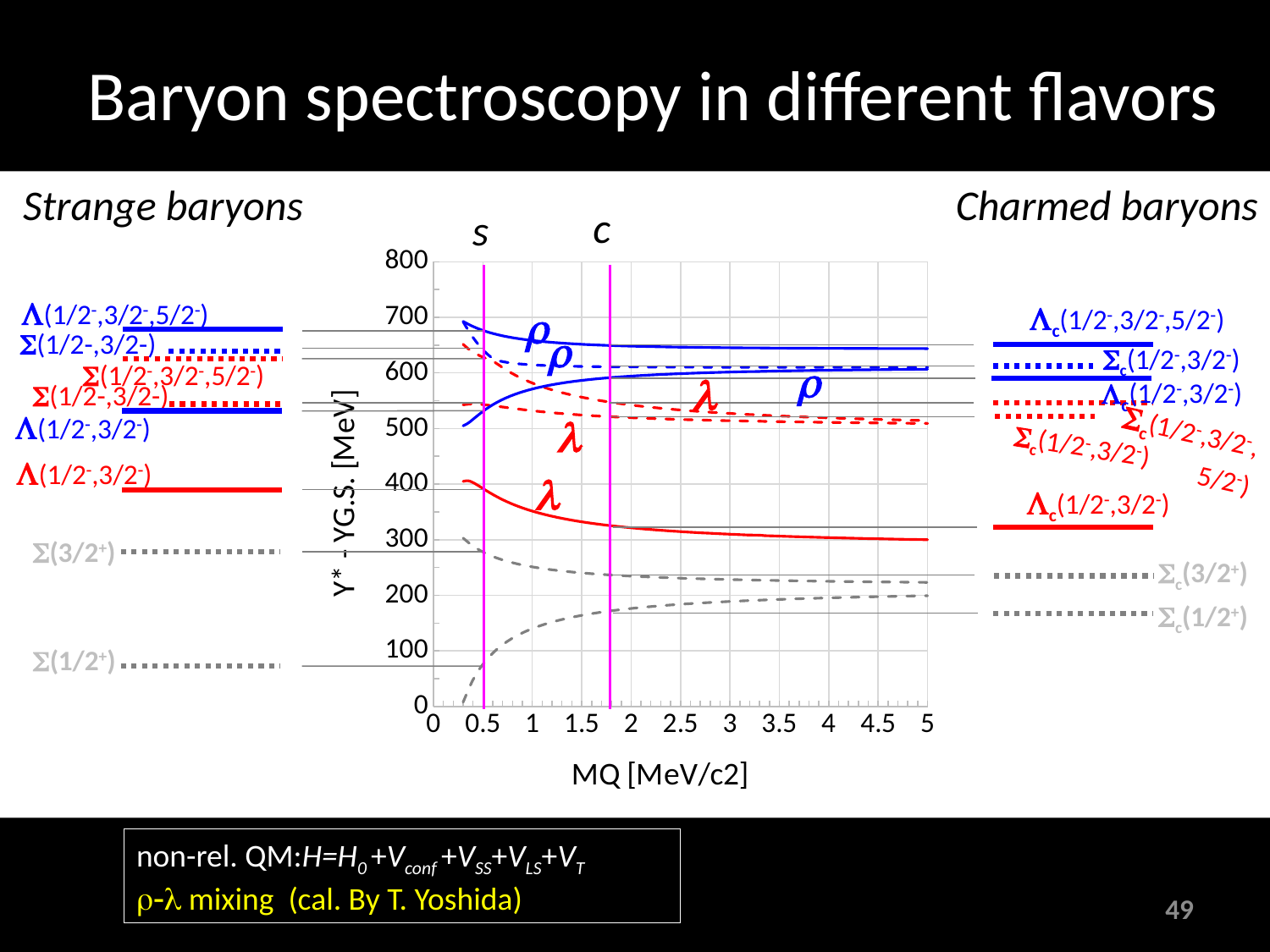
How many vertical magenta lines are drawn on the chart? 2 What kind of chart is shown on the slide? line chart Does the lowest gray dashed curve rise or fall as MQ increases along the x axis? rise Does the solid red λ curve rise or fall as MQ increases along the x axis? fall What is the highest value shown on the y axis of the chart? 800 Does the uppermost solid blue ρ curve rise or fall as MQ increases along the x axis? fall Is the value of the lowest gray dashed curve at MQ = 5 greater or less than 300? less What is the label of the x axis of the chart? MQ [MeV/c2] What is the label of the y axis of the chart? Y* - YG.S. [MeV] Is the value of the solid red λ curve at MQ = 5 greater or less than 400? less Is the value of the uppermost solid blue ρ curve at MQ = 5 greater or less than 600? greater What is the highest value shown on the x axis of the chart? 5